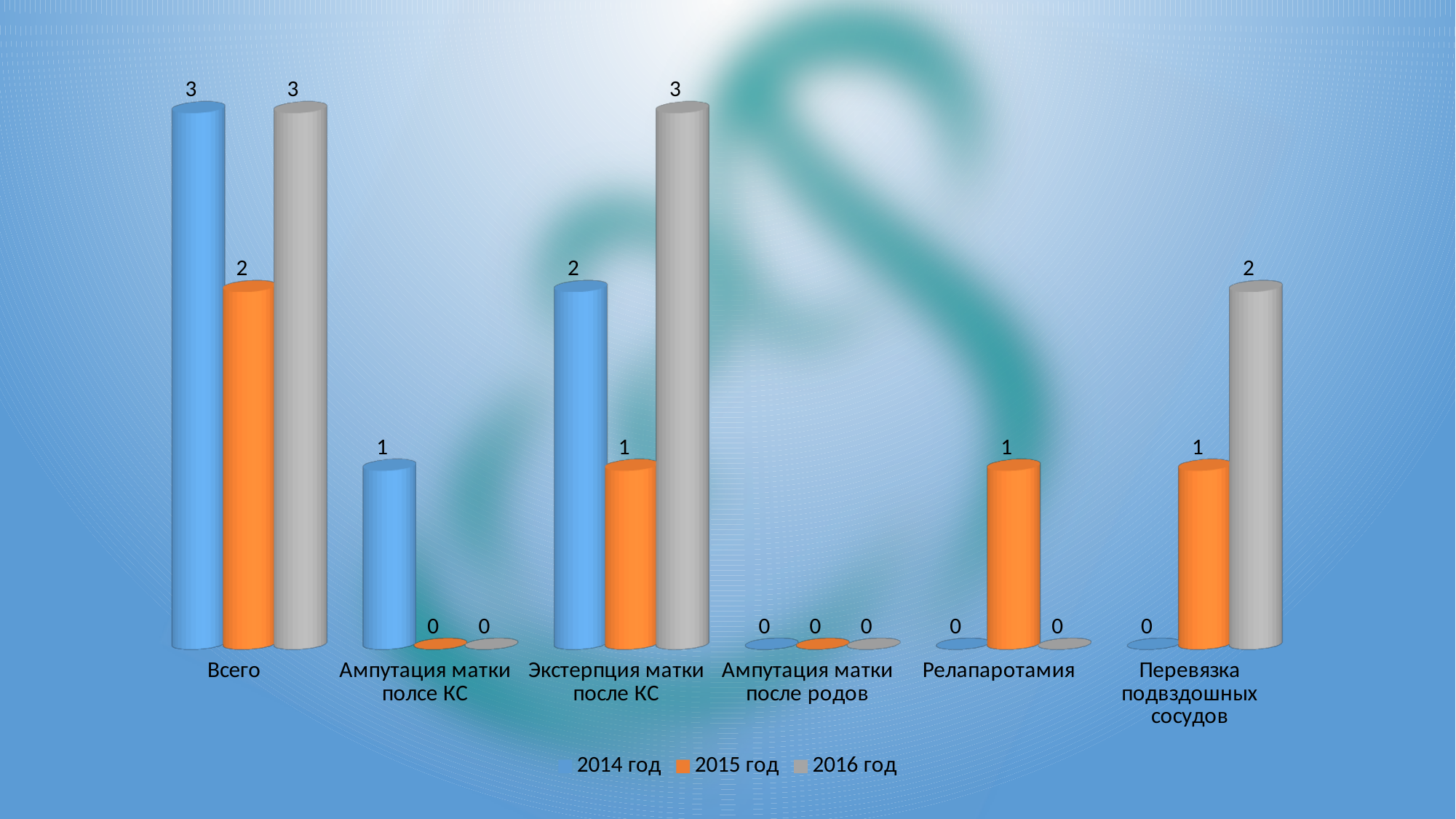
What kind of chart is shown on the slide? Bar chart Which is larger for "Перевязка подвздошных сосудов": the 2015 год value or the 2016 год value? 2016 год Which category has the highest value in the 2016 год series, excluding "Всего"? Экстерпция матки после КС What is the value for "Релапаротамия" in the 2015 год series? 1 What is the total of the three series values for "Ампутация матки после родов"? 0 Which colour represents the 2015 год series in the legend? Orange What is the value for "Экстерпция матки после КС" in the 2016 год series? 3 How many series does the legend list? 3 What is the value for "Всего" in the 2015 год series? 2 What is the difference between the 2016 год and 2015 год values for "Экстерпция матки после КС"? 2 What is the value for "Перевязка подвздошных сосудов" in the 2014 год series? 0 How many categories are shown on the x axis? 6